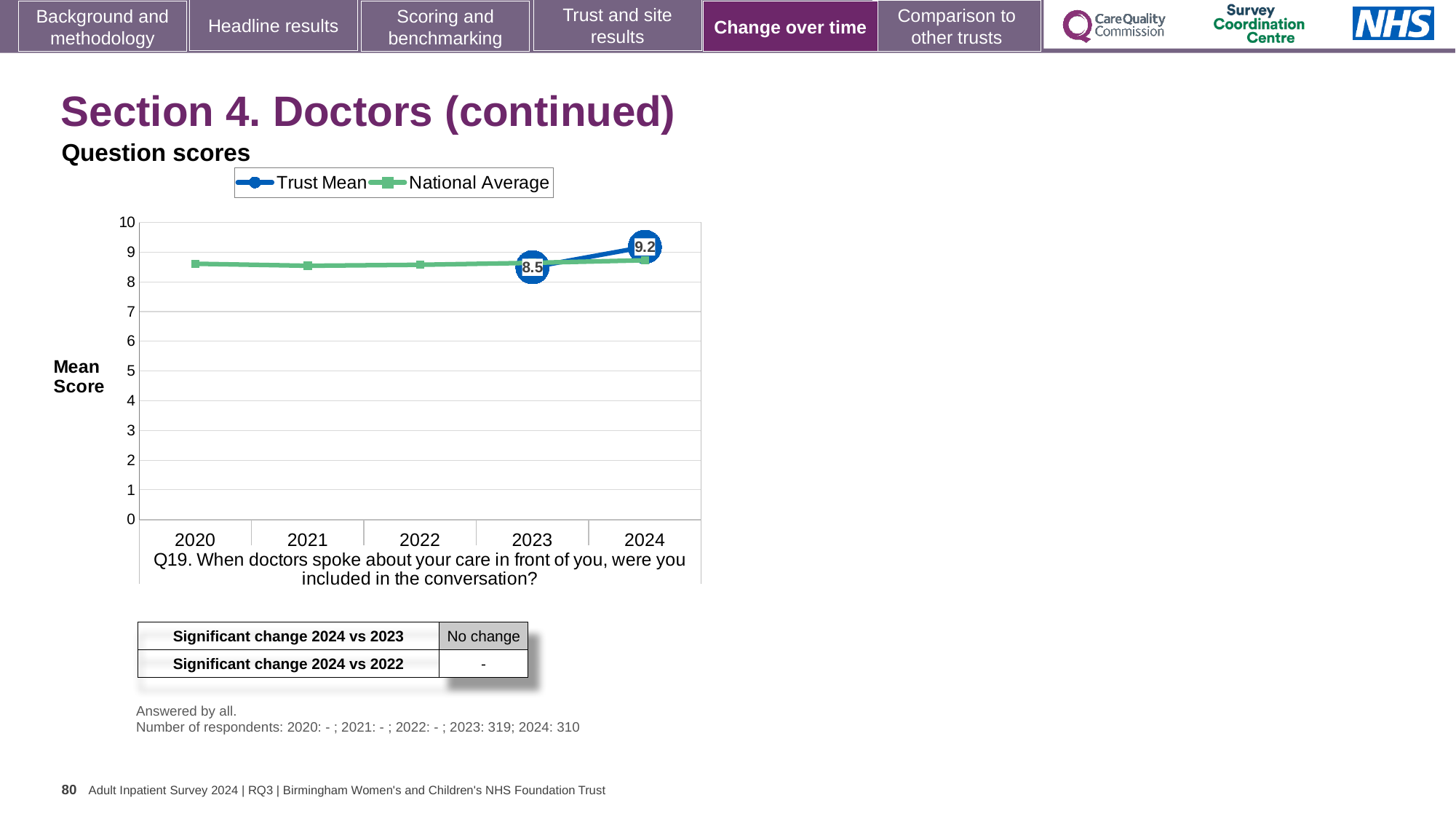
What kind of chart is shown on the slide? line chart How many years are shown on the x axis of the chart? 5 What is the difference between the Trust Mean score in 2024 and in 2023? 0.7 What is the Trust Mean score for 2024? 9.2 Does the Trust Mean rise or fall from 2023 to 2024? rise Is the National Average value for 2022 greater or less than 9? less In 2024, which is higher, the Trust Mean or the National Average? Trust Mean Which year has the higher Trust Mean score, 2023 or 2024? 2024 How many series does the chart legend list? 2 Is the National Average value for 2020 greater or less than 8? greater What is the Trust Mean score for 2023? 8.5 Which survey question does the chart relate to? Q19. When doctors spoke about your care in front of you, were you included in the conversation?